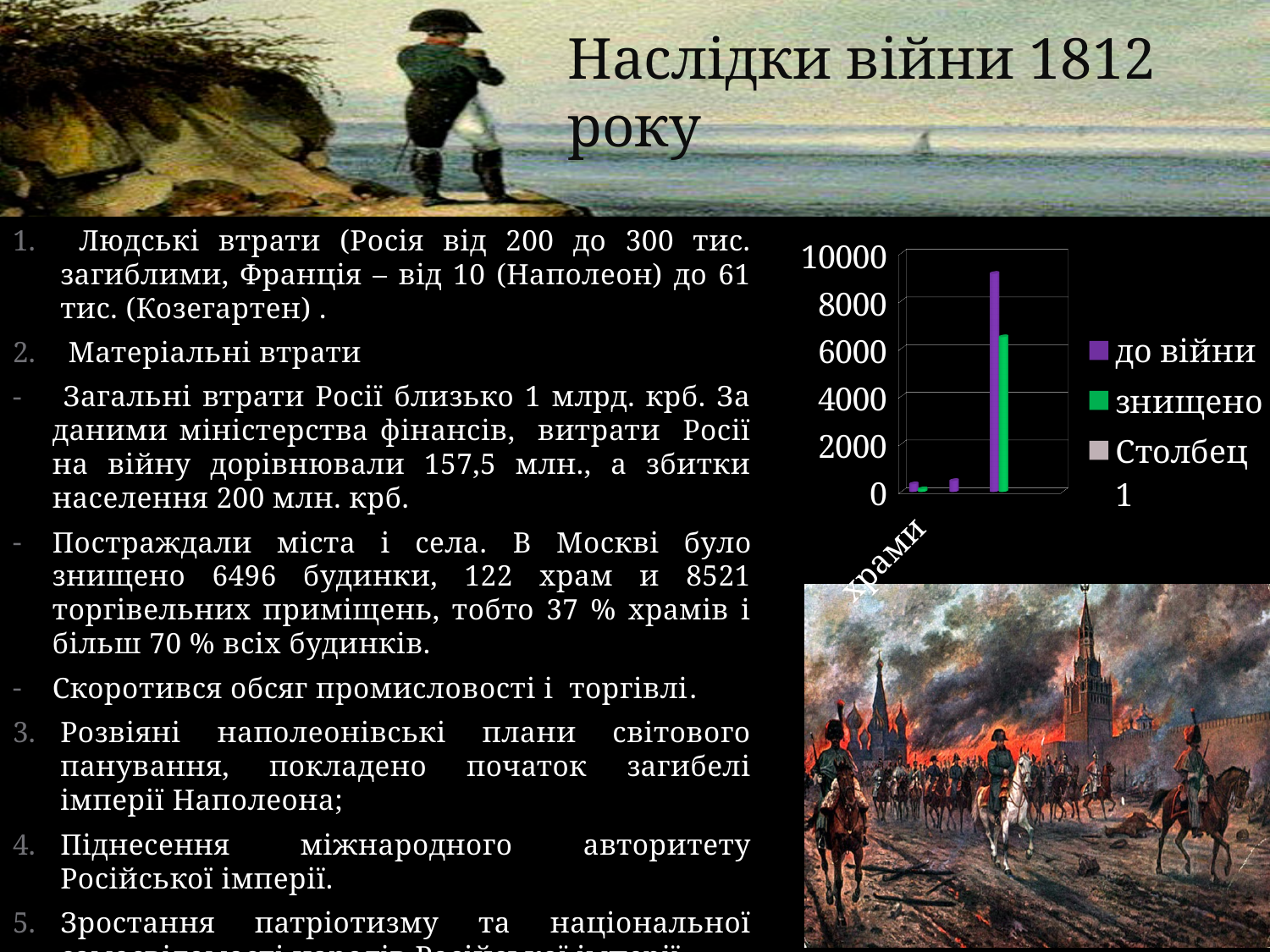
In the rightmost group of bars, which series has the taller bar, 'до війни' or 'знищено'? до війни What is the highest value shown on the chart's vertical axis? 10000 Is the tallest bar on the chart greater or less than 8000? greater Is the value for 'храми' in the series 'до війни' greater or less than 2000? less What kind of chart is shown on the slide? bar chart Is the value for 'храми' in the series 'знищено' greater or less than 2000? less How many groups of bars are plotted on the chart? 3 What are the series names listed in the chart legend? до війни, знищено, Столбец 1 Which colour represents the series 'до війни' in the chart? purple How many series does the chart legend list? 3